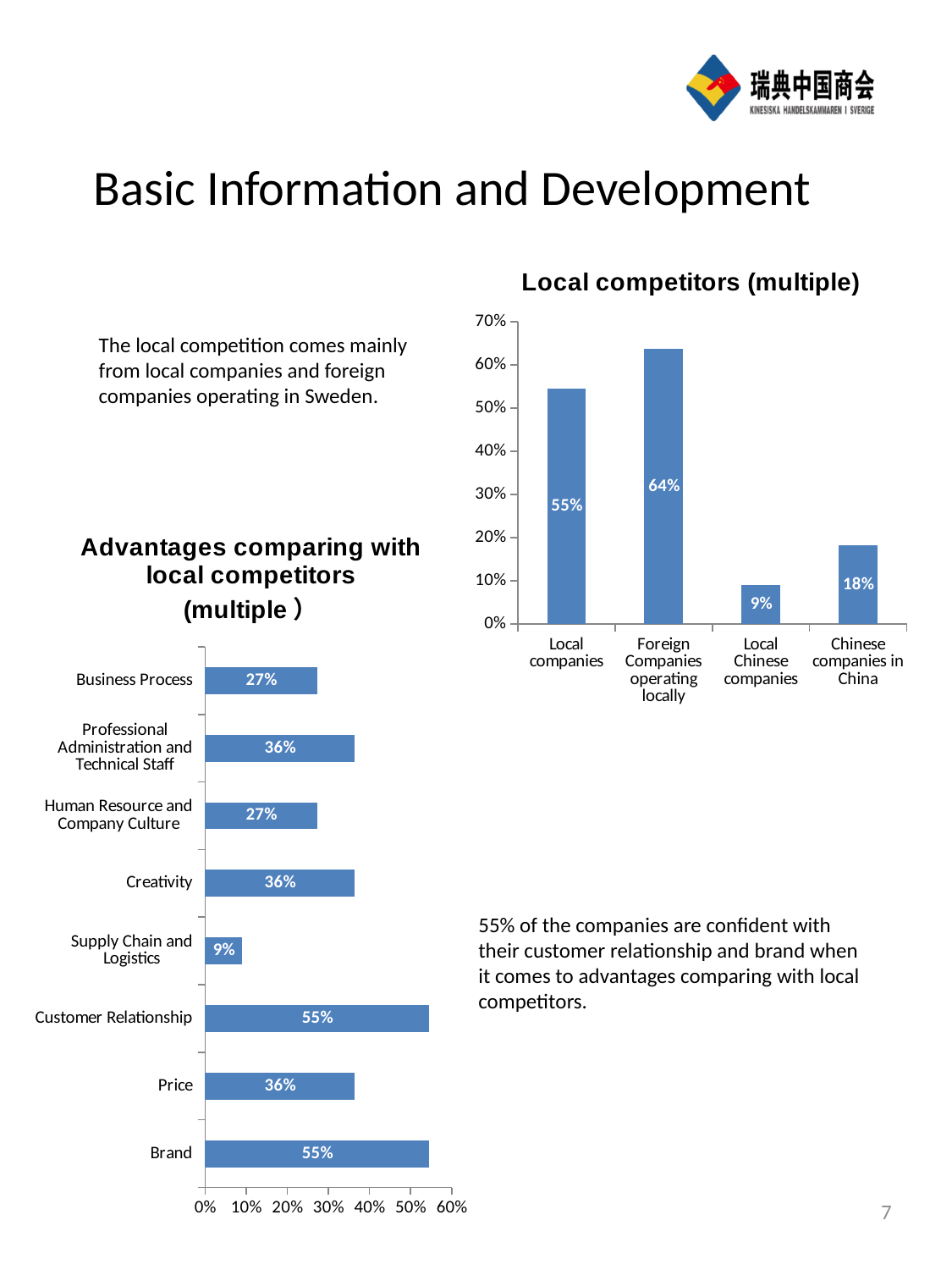
In the 'Local competitors (multiple)' chart, which category has the lowest value? Local Chinese companies In the 'Local competitors (multiple)' chart, what is the value for Foreign Companies operating locally? 64% In the 'Local competitors (multiple)' chart, how many categories are shown? 4 In the 'Advantages comparing with local competitors (multiple)' chart, which category has the lowest value? Supply Chain and Logistics In the 'Advantages comparing with local competitors (multiple)' chart, how many categories are shown? 8 In the 'Local competitors (multiple)' chart, what is the value for Local Chinese companies? 9% What kind of chart is the 'Local competitors (multiple)' chart? Bar chart In the 'Advantages comparing with local competitors (multiple)' chart, what is the value for Customer Relationship? 55% In the 'Local competitors (multiple)' chart, which category has the highest value? Foreign Companies operating locally In the 'Advantages comparing with local competitors (multiple)' chart, which is larger: Price or Business Process? Price In the 'Advantages comparing with local competitors (multiple)' chart, what is the value for Creativity? 36% In the 'Local competitors (multiple)' chart, what is the difference between the values for Local companies and Chinese companies in China? 37%